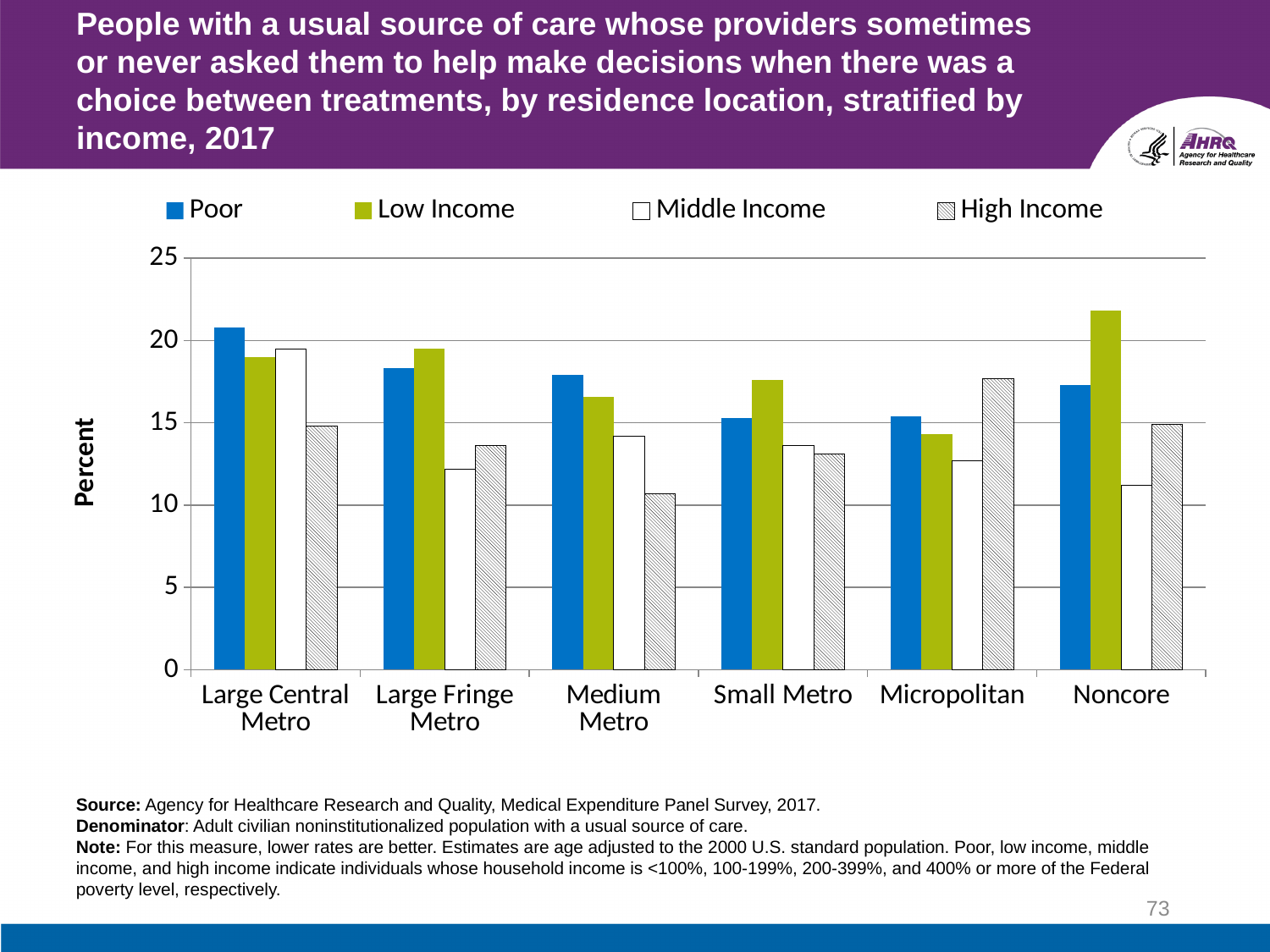
In Micropolitan, which is larger: the Poor value or the High Income value? High Income Is the value for Low Income in Noncore greater or less than 20? greater How many residence location categories are shown on the x axis? 6 Is the value for Poor in Medium Metro greater or less than 15? greater Is the value for High Income in Medium Metro greater or less than 15? less How many series does the legend list? 4 Which residence location has the lowest High Income value? Medium Metro Which residence location has the highest Low Income value? Noncore What is the label on the y axis? Percent What kind of chart is shown on the slide? Bar chart In Large Fringe Metro, which is larger: the Middle Income value or the High Income value? High Income